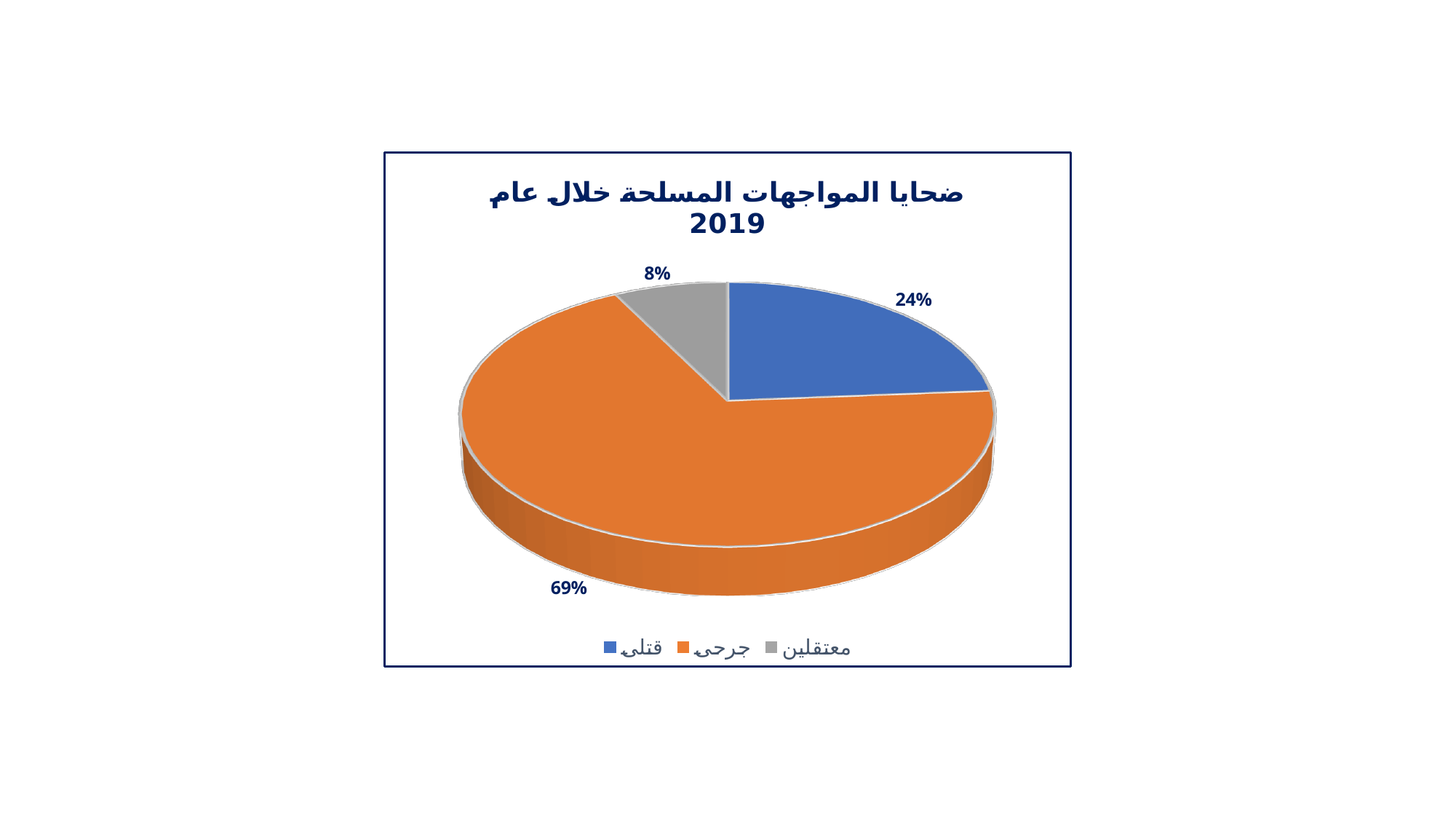
What is the title of the chart? ضحايا المواجهات المسلحة خلال عام 2019 What is the difference in percentage points between جرحى and قتلى? 45 What share of the pie does معتقلين represent? 8% How many entries does the legend list? 3 What share of the pie does جرحى represent? 69% Which is larger, the share for قتلى or the share for معتقلين? قتلى How many categories does the pie chart show? 3 What share of the pie does قتلى represent? 24% Which category has the largest slice of the pie? جرحى What colour is the slice for جرحى? Orange What kind of chart is shown on the slide? Pie chart Which category has the smallest slice of the pie? معتقلين